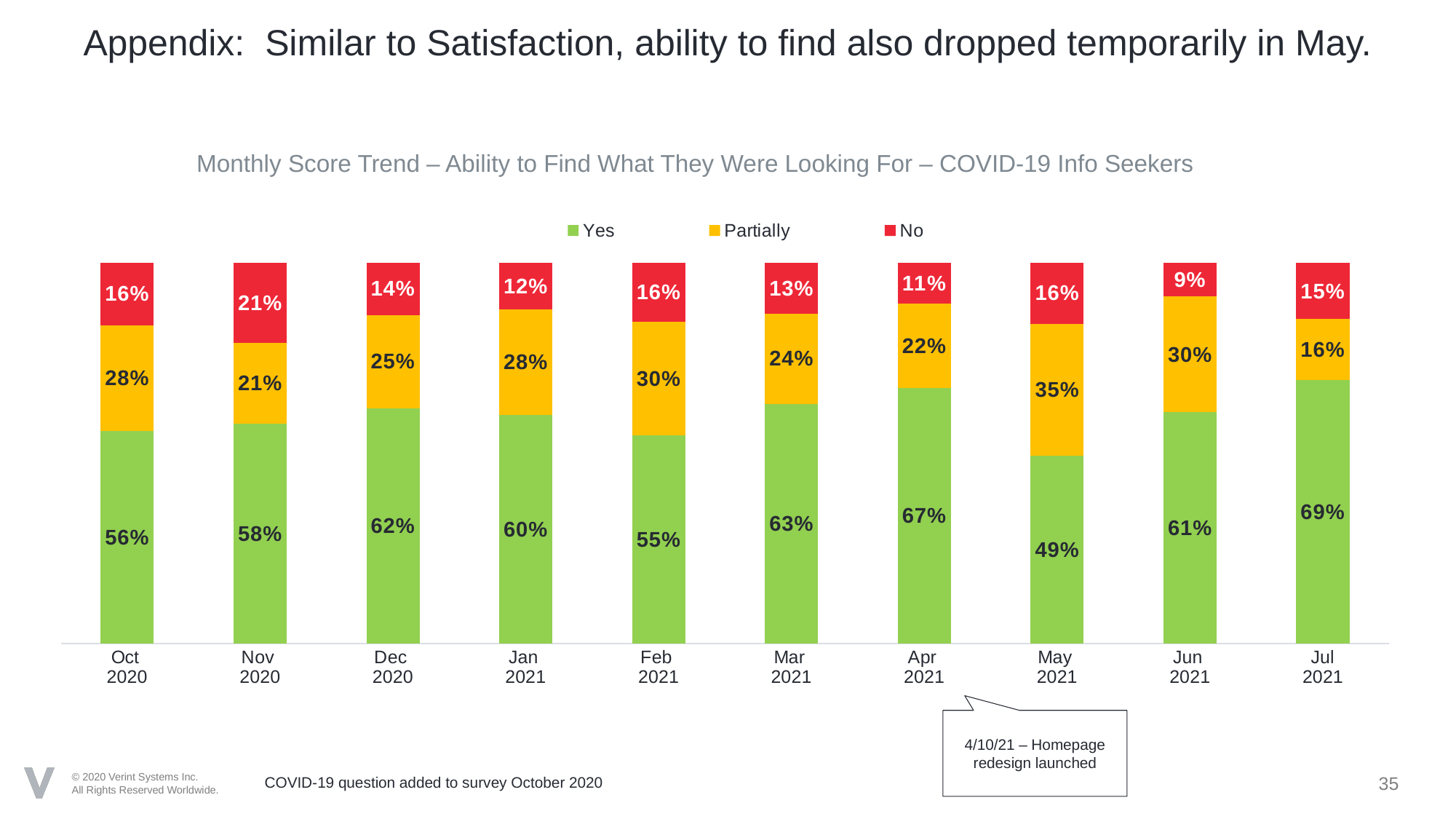
What is the 'Partially' value for Jun 2021? 30% What is the total of the stacked bar for Oct 2020? 100% Which month has the lowest 'No' value? Jun 2021 Which colour represents the 'No' series? Red Which is larger, the 'Partially' value for May 2021 or for Jul 2021? May 2021 What is the 'Yes' value for May 2021? 49% What kind of chart is shown? Stacked bar chart How many series does the legend list? 3 What is the difference between the 'Yes' values for Apr 2021 and May 2021? 18% Which month has the highest 'Yes' value? Jul 2021 What is the 'No' value for Nov 2020? 21% How many months are shown on the x axis? 10